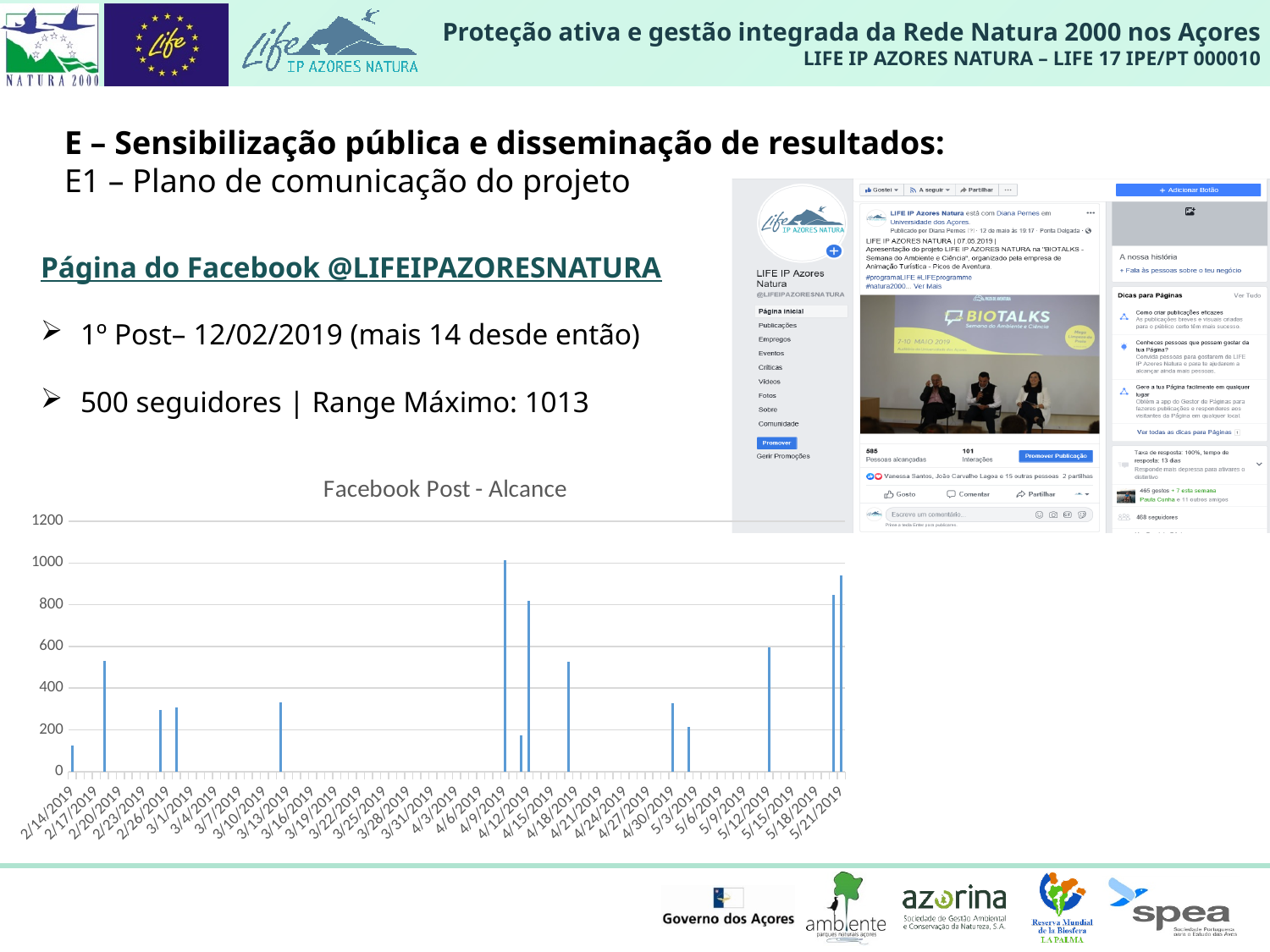
What kind of chart is shown on the slide? bar chart Is the value for 5/21/2019 greater or less than 800? greater Is the value for 4/18/2019 greater or less than 400? greater Is the value for 4/9/2019 greater or less than 800? greater What is the title of the chart? Facebook Post - Alcance Which is larger, the value for 4/9/2019 or the value for 2/14/2019? 4/9/2019 What is the highest value shown on the y axis of the chart? 1200 Which date has the highest bar in the chart? 4/9/2019